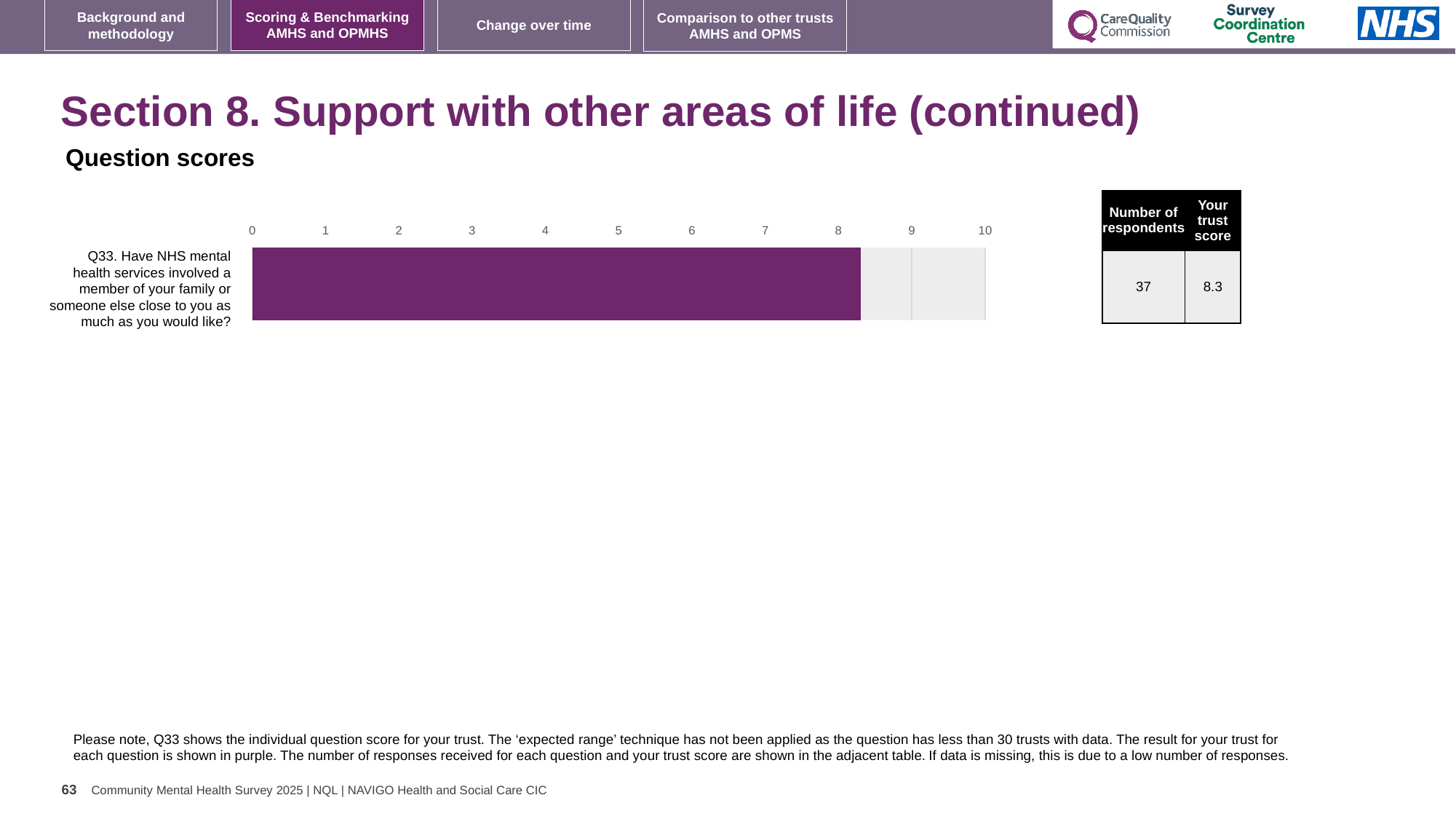
What colour is the bar for Q33? Purple Which question number does the single bar in the chart represent? Q33 How many respondents answered Q33 according to the table beside the chart? 37 Is the value of the bar for Q33 greater or less than 8? greater How many bars are plotted in the chart? 1 What is the trust score for Q33 shown in the table next to the chart? 8.3 Is the value of the bar for Q33 greater or less than 5? greater What is the maximum value shown on the chart's axis? 10 What kind of chart is shown on the slide? Bar chart Is the value of the bar for Q33 greater or less than 9? less